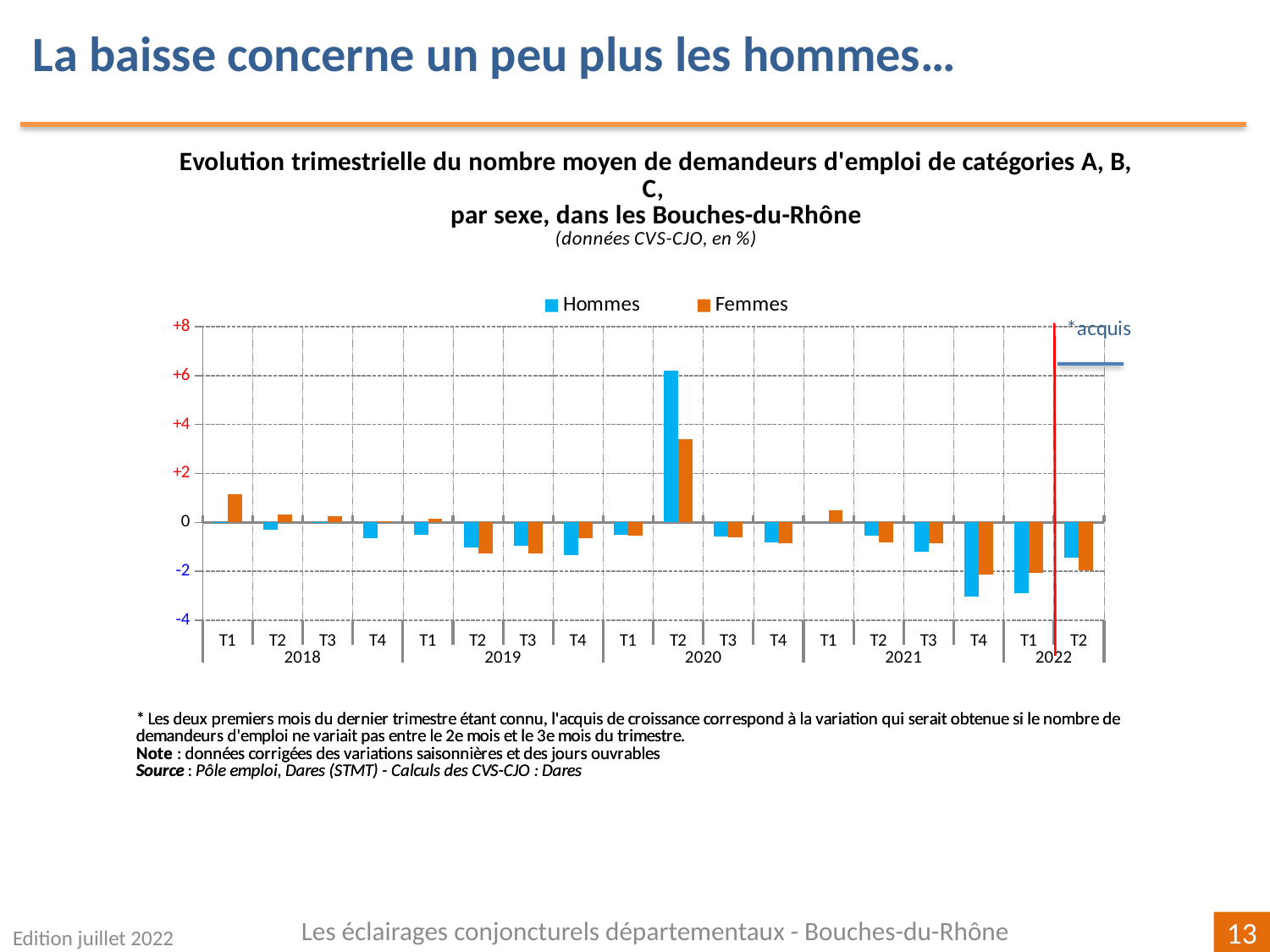
How many series does the legend list? 2 How many quarters are shown on the x axis? 18 In T4 2021, which series has the higher (less negative) value, Hommes or Femmes? Femmes Is the value for Hommes in T4 2021 greater or less than -2? less Is the value for Hommes in T2 2020 greater or less than +4? greater What kind of chart is shown on the slide? bar chart In which quarter is the value for Hommes the highest? T2 2020 Is the value for Femmes in T2 2020 greater or less than +4? less Which colour represents the Femmes series in the legend? orange In which quarter is the value for Femmes the highest? T2 2020 In T2 2020, which series has the higher value, Hommes or Femmes? Hommes